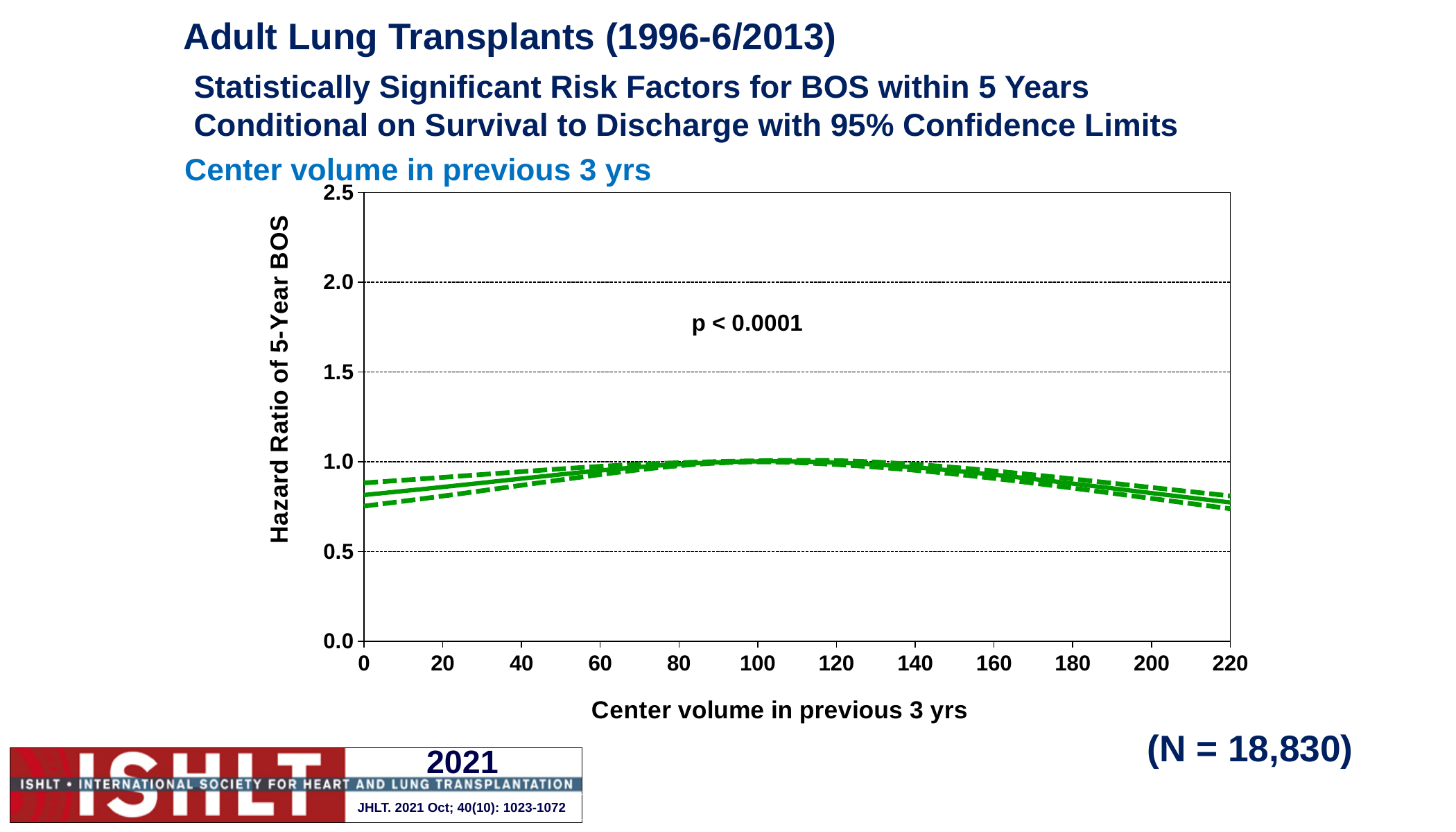
What is the highest value shown on the x axis? 220 What kind of chart is shown on the slide? line chart How does the hazard ratio change as center volume increases from 120 to 220? it falls Is the hazard ratio at a center volume of 20 greater or less than 0.5? greater Is the hazard ratio at a center volume of 0 greater or less than 1.0? less What p-value is printed on the chart? p < 0.0001 Is the hazard ratio at a center volume of 200 greater or less than 1.5? less What is the title of the chart? Center volume in previous 3 yrs What is the label of the y axis? Hazard Ratio of 5-Year BOS How does the hazard ratio change as center volume increases from 0 to 100? it rises What is the highest value shown on the y axis? 2.5